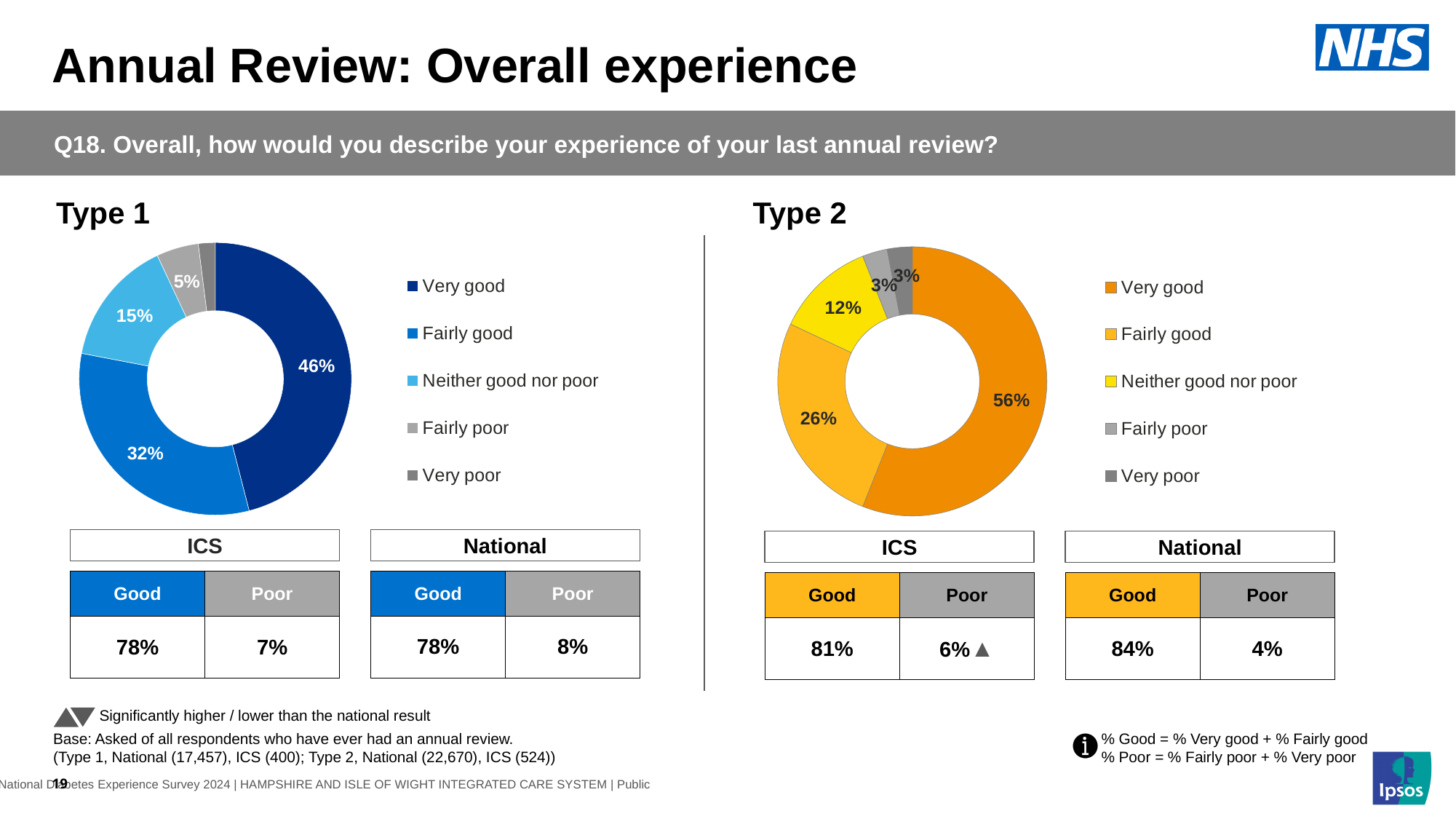
How many response categories does the legend of the Type 1 chart list? 5 In the Type 1 chart, what is the difference between the 'Very good' and 'Fairly good' percentages? 14% Which chart has the larger 'Very good' share, Type 1 or Type 2? Type 2 In the Type 2 chart, what percentage of respondents said 'Neither good nor poor'? 12% What kind of chart is used for the Type 2 data? Doughnut (pie) chart In the Type 2 chart, what is the difference between the 'Very good' and 'Neither good nor poor' percentages? 44% In the Type 1 chart, which response category has the smallest share? Very poor In the Type 2 chart, what percentage of respondents said their experience was 'Fairly good'? 26% In the Type 1 chart, what percentage of respondents said 'Neither good nor poor'? 15% In the Type 1 chart, what colour represents 'Very good'? Dark blue In the Type 1 chart, what percentage of respondents said their experience was 'Very good'? 46% In the Type 2 chart, which response category has the largest share? Very good